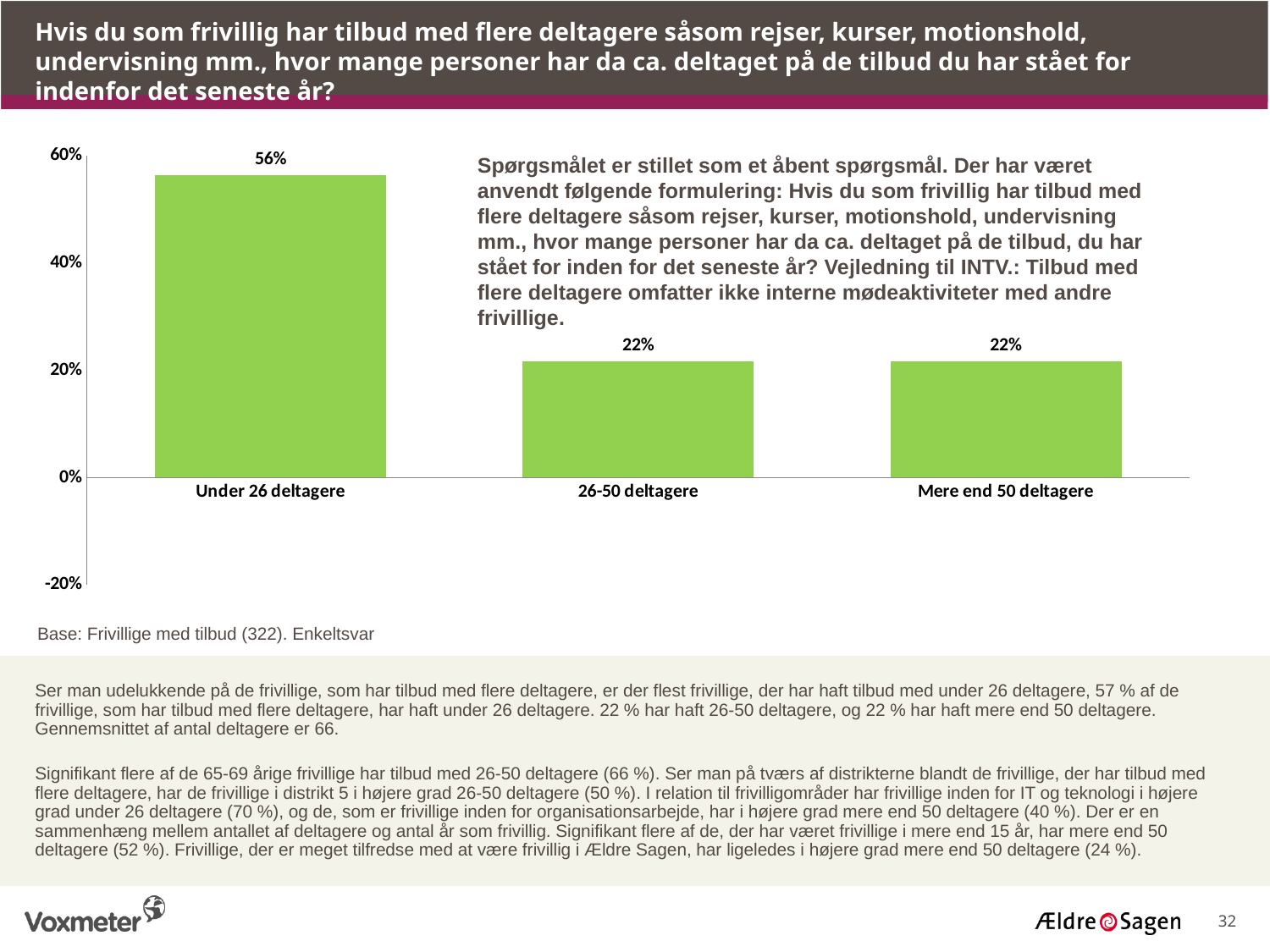
How many categories are shown on the chart? 3 Which is larger, the value for "Under 26 deltagere" or the value for "Mere end 50 deltagere"? Under 26 deltagere What is the difference between the values for "Under 26 deltagere" and "26-50 deltagere"? 34 percentage points What colour are the bars in the chart? Green What is the lowest value shown on the vertical axis? -20% What kind of chart is shown on the slide? Bar chart What is the value for "26-50 deltagere"? 22% What is the value for "Under 26 deltagere"? 56% What is the value for "Mere end 50 deltagere"? 22% Is the value for "26-50 deltagere" greater or less than 40%? less Which category has the highest value? Under 26 deltagere Is the value for "Under 26 deltagere" greater or less than 40%? greater